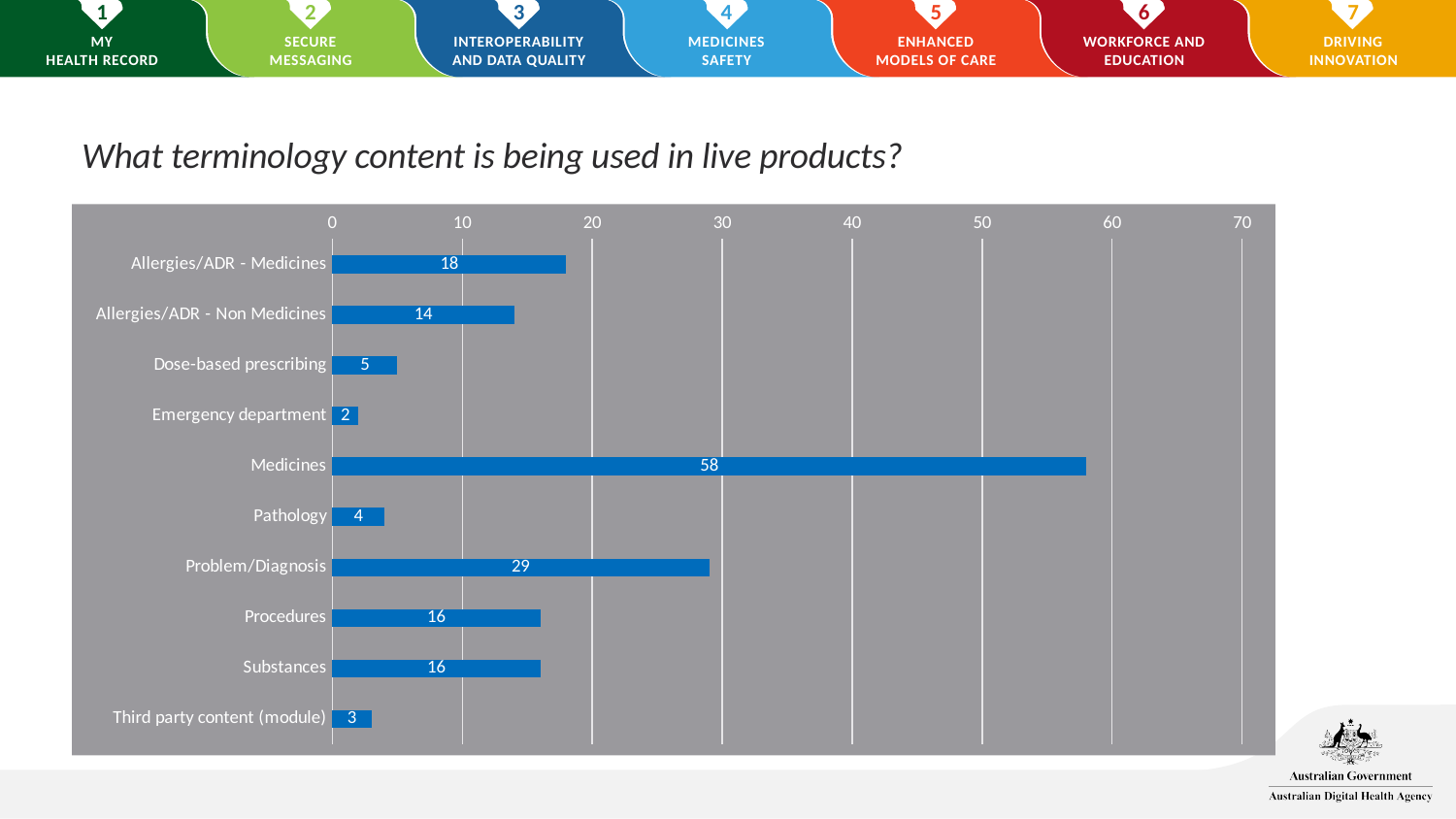
What kind of chart is shown on the slide? Bar chart What is the value for Medicines? 58 Which is larger, the value for Allergies/ADR - Medicines or Allergies/ADR - Non Medicines? Allergies/ADR - Medicines What is the value for Problem/Diagnosis? 29 What is the difference between the values for Medicines and Problem/Diagnosis? 29 How many categories are shown in the chart? 10 What is the title of the slide above the chart? What terminology content is being used in live products? What is the difference between the values for Procedures and Pathology? 12 Which category has the highest value? Medicines Is the value for Problem/Diagnosis greater or less than 20? greater Which category has the lowest value? Emergency department What is the value for Emergency department? 2